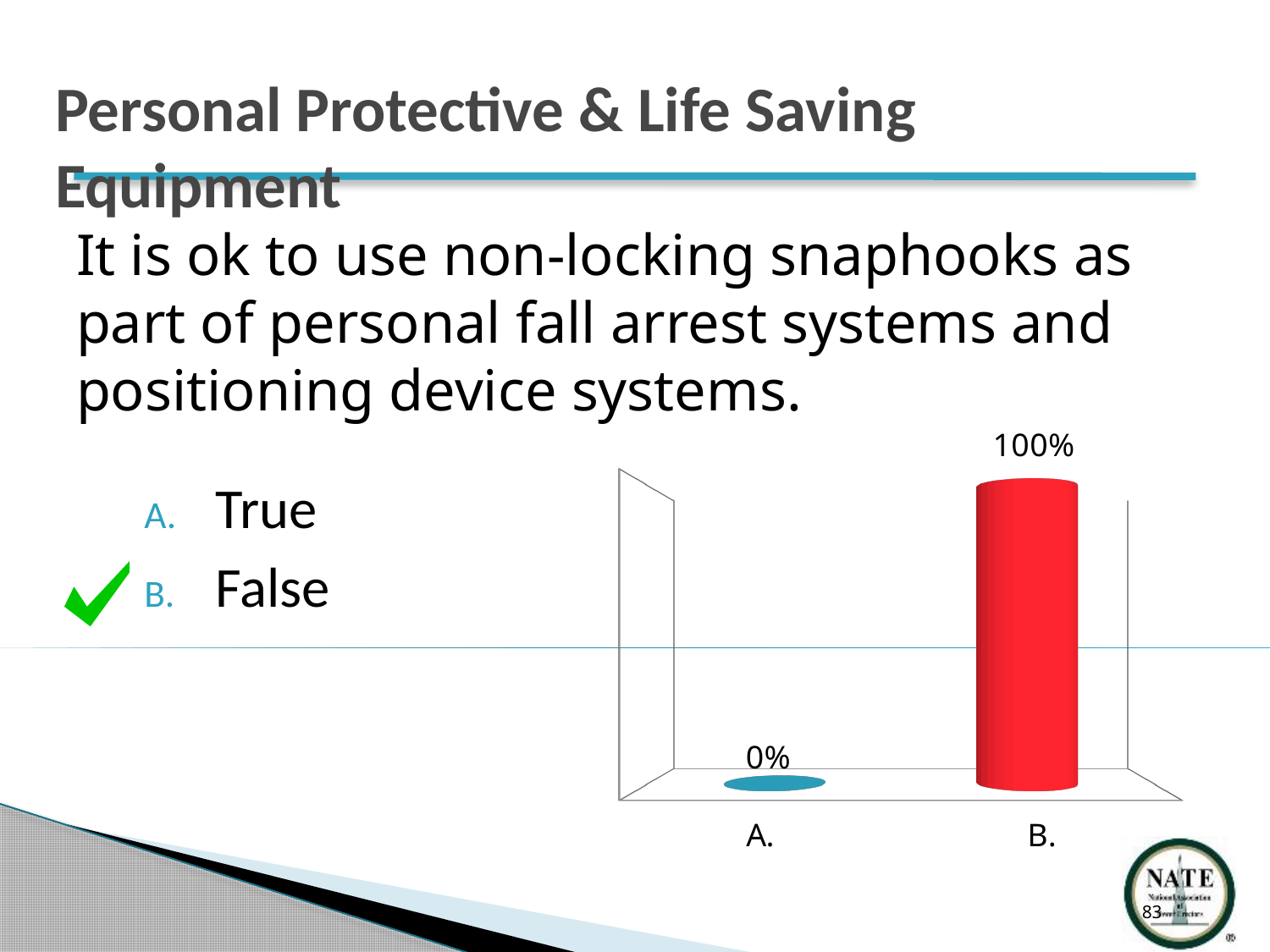
What kind of chart is shown on the slide? bar chart Which category has the larger value, A. or B.? B. Which category has the highest value in the chart? B. What colour is the bar for category B.? red How many categories are shown in the chart? 2 Do the values rise or fall from A. to B. along the x axis? rise What is the value for category B. in the chart? 100% What is the difference between the values for B. and A.? 100% Which category has the lowest value in the chart? A. Which answer option is marked with a check mark on the slide? B. False What is the value for category A. in the chart? 0%